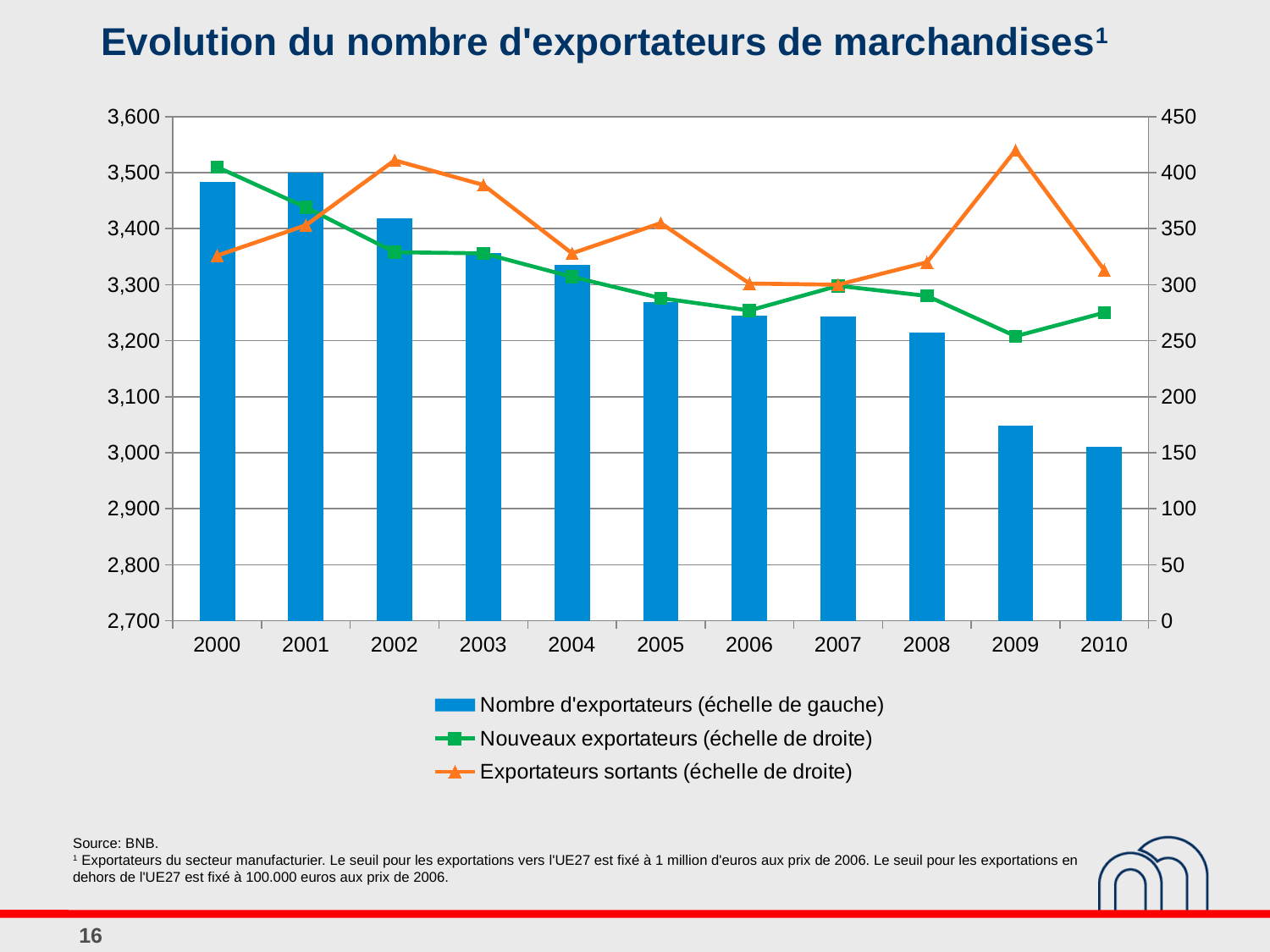
Which year has the lowest value for Nouveaux exportateurs? 2009 Which year has the highest value for Nouveaux exportateurs? 2000 How many series does the legend list? 3 Which year has the highest value for Exportateurs sortants? 2009 Is the value for Exportateurs sortants in 2009 greater or less than 400? greater Which is larger, Nombre d'exportateurs in 2002 or in 2008? 2002 What kind of chart is shown on the slide? A combined bar and line chart Do the values for Nombre d'exportateurs generally rise or fall from 2000 to 2010? fall How many years are shown on the x axis? 11 Is the value for Nombre d'exportateurs in 2000 greater or less than 3,400? greater Which year has the lowest value for Nombre d'exportateurs? 2010 Is the value for Nombre d'exportateurs in 2010 greater or less than 3,100? less